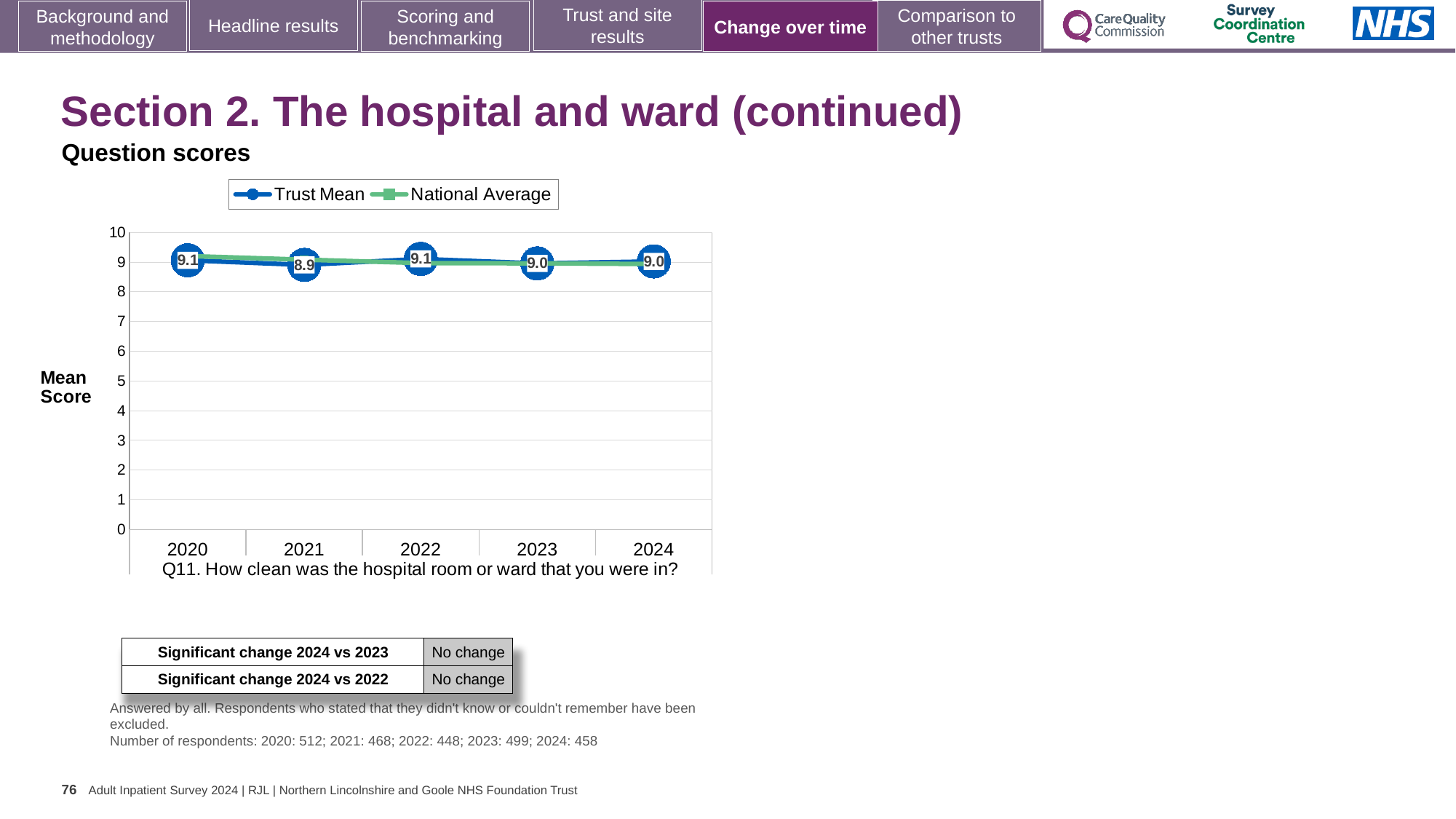
Is the National Average value for 2024 greater or less than 8? greater Which is larger, the Trust Mean for 2020 or for 2021? 2020 In which year is the Trust Mean lowest? 2021 What question does the chart relate to, as shown below the x axis? Q11. How clean was the hospital room or ward that you were in? What is the Trust Mean value for 2024? 9.0 How many years are shown on the x axis? 5 How many series does the legend list? 2 What kind of chart is shown? Line chart What is the Trust Mean value for 2020? 9.1 What is the Trust Mean value for 2021? 8.9 What is the difference between the Trust Mean in 2022 and in 2021? 0.2 What are the two series named in the legend? Trust Mean and National Average